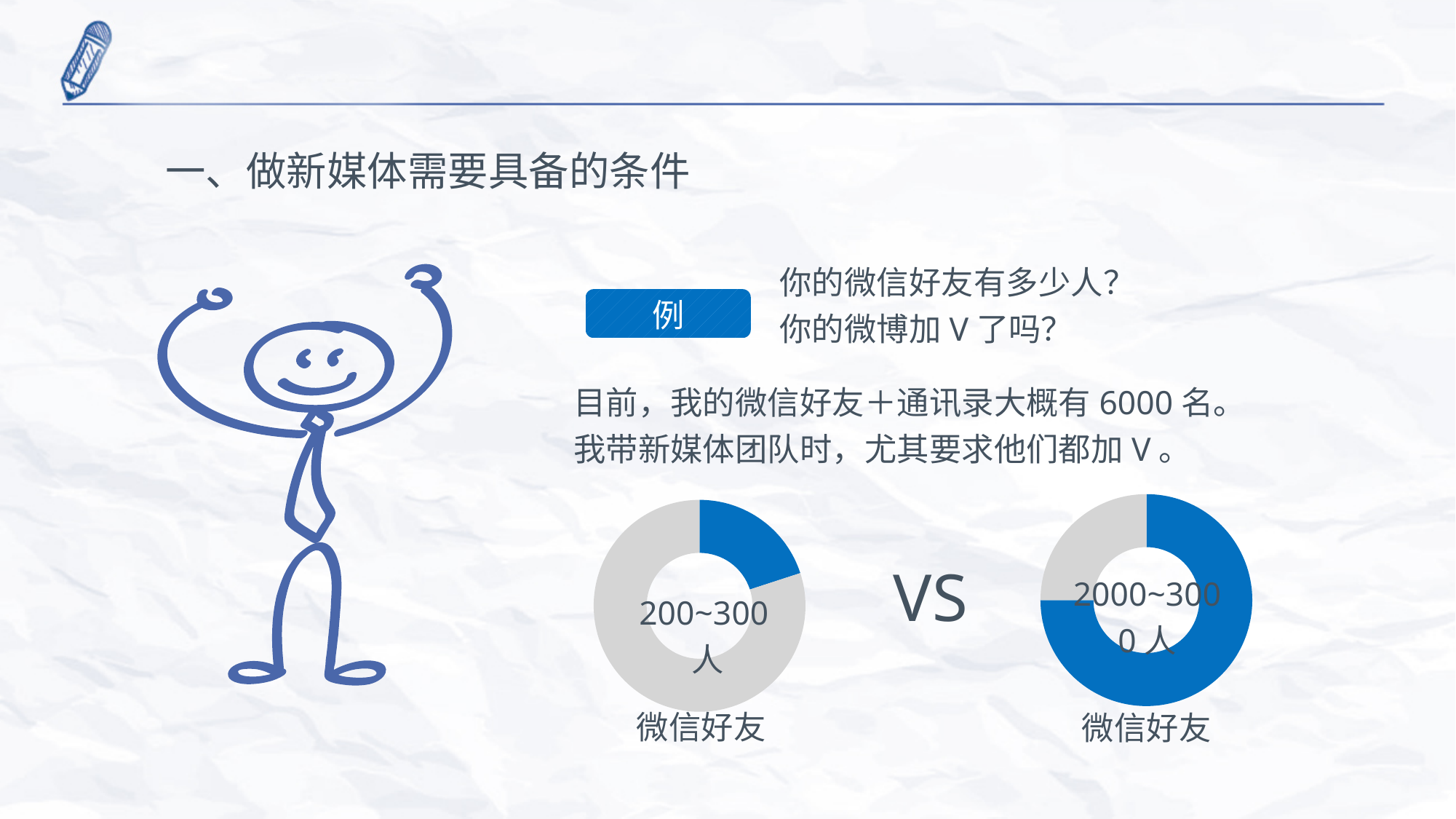
What text is printed in the centre of the left donut chart? 200~300人 What kind of chart is shown on the left side of the slide, below the text? Donut chart In the right donut chart, is the blue portion larger or smaller than the grey portion? Larger What label appears beneath the left donut chart? 微信好友 How many coloured segments does each donut chart have? 2 What word is printed between the two donut charts? VS What label appears beneath the right donut chart? 微信好友 In the left donut chart, is the blue portion larger or smaller than the grey portion? Smaller How many donut charts are shown on the slide? 2 What text is printed in the centre of the right donut chart? 2000~3000人 Which donut chart has the larger blue portion, the left one or the right one? The right one